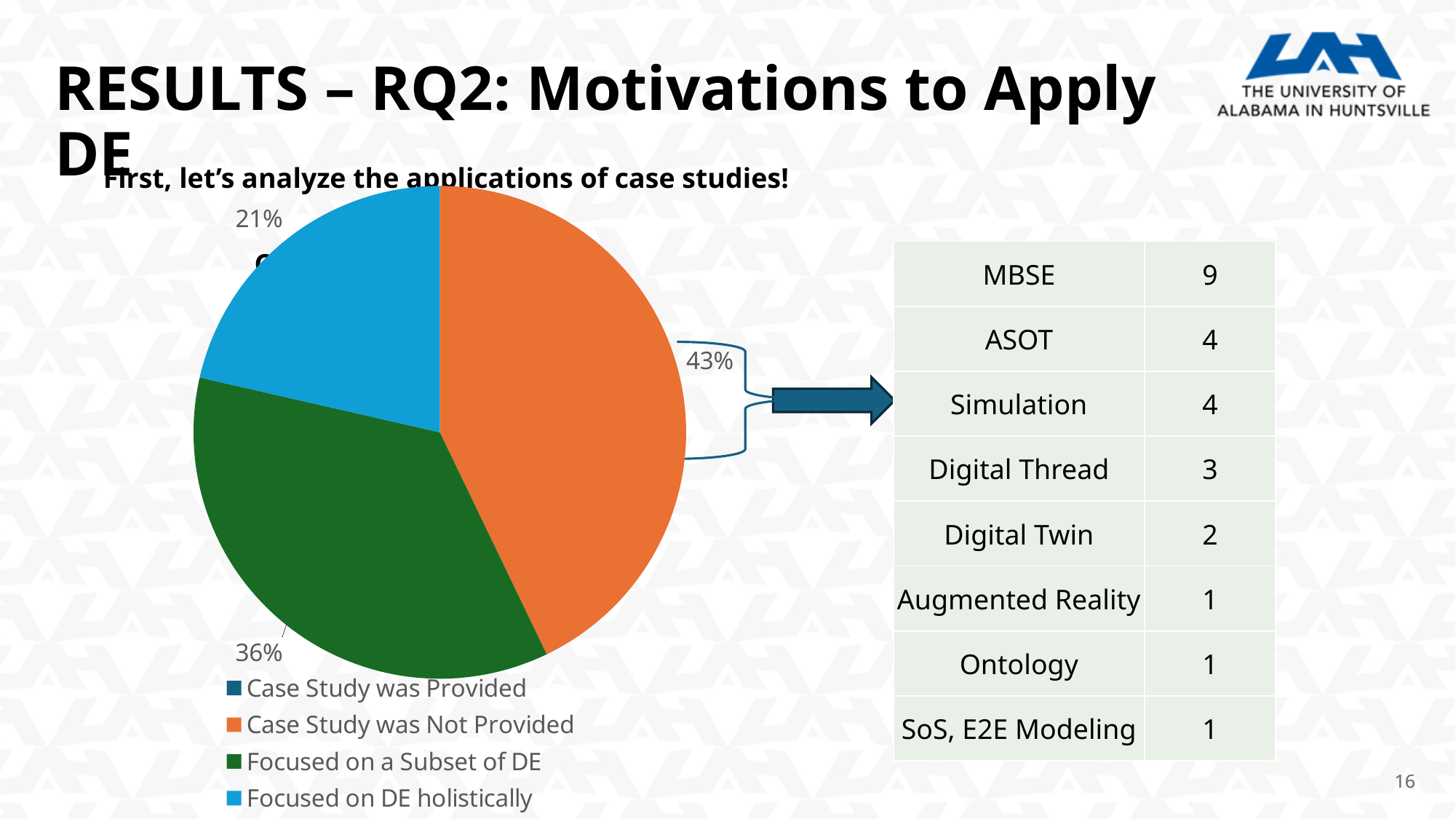
What colour represents 'Focused on a Subset of DE' in the pie chart? Green What is the difference in percentage points between the 'Case Study was Not Provided' slice and the 'Focused on DE holistically' slice? 22 percentage points How many entries does the legend of the pie chart list? 4 Which category has the largest slice in the pie chart? Case Study was Not Provided What colour represents 'Case Study was Not Provided' in the pie chart? Orange Which slice is larger in the pie chart: 'Focused on a Subset of DE' or 'Focused on DE holistically'? Focused on a Subset of DE What percentage of the pie chart is labelled for 'Case Study was Not Provided'? 43% What percentage of the pie chart is labelled for 'Focused on DE holistically'? 21% What type of chart is shown on the slide? Pie chart By how many percentage points does 'Case Study was Not Provided' exceed 'Focused on a Subset of DE' in the pie chart? 7 percentage points Which of the slices with a percentage label is the smallest in the pie chart? Focused on DE holistically What percentage of the pie chart is labelled for 'Focused on a Subset of DE'? 36%